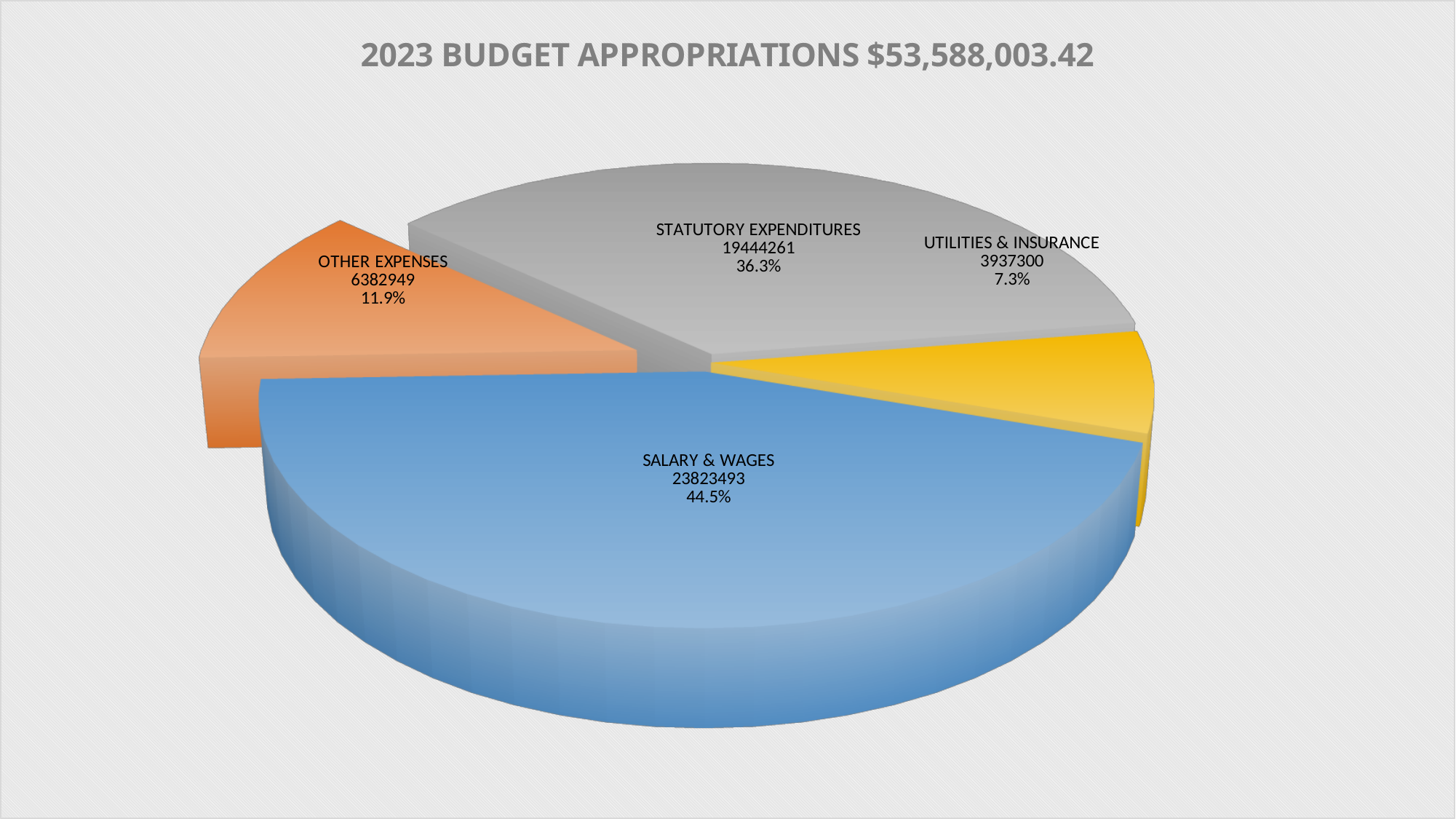
What is the value for STATUTORY EXPENDITURES? 19444261 What is the value for OTHER EXPENSES? 6382949 Which category has the largest slice? SALARY & WAGES What is the value for UTILITIES & INSURANCE? 3937300 What type of chart is shown on the slide? Pie chart What is the difference between the values for SALARY & WAGES and STATUTORY EXPENDITURES? 4379232 Which is larger, OTHER EXPENSES or UTILITIES & INSURANCE? OTHER EXPENSES What share of the pie does STATUTORY EXPENDITURES represent? 36.3% What is the value for SALARY & WAGES? 23823493 Which category has the smallest slice? UTILITIES & INSURANCE How many categories are shown in the pie chart? 4 What share of the pie does UTILITIES & INSURANCE represent? 7.3%